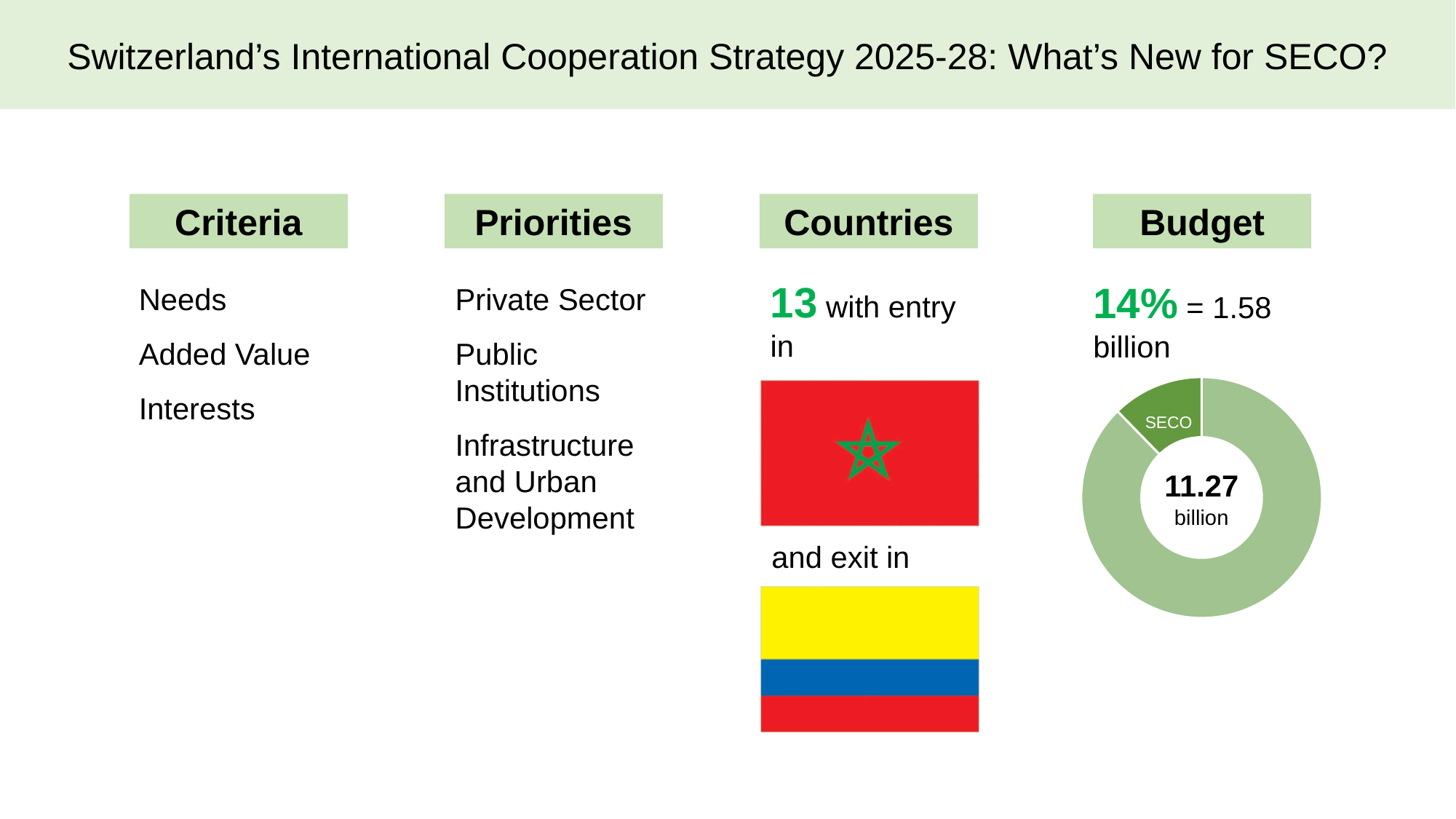
Which slice of the Budget donut chart is labelled? SECO Which slice of the Budget donut chart is the smallest? SECO What amount corresponds to the SECO share of the budget, according to the slide? 1.58 billion How many slices does the Budget donut chart have? 2 In the Budget donut chart, is the SECO slice larger or smaller than the remaining slice? Smaller What value is printed in the centre of the Budget donut chart? 11.27 billion What kind of chart is shown under the Budget heading? Donut (pie) chart What share of the budget does the SECO slice represent, according to the slide? 14% What colour is the SECO slice in the Budget donut chart? Dark green